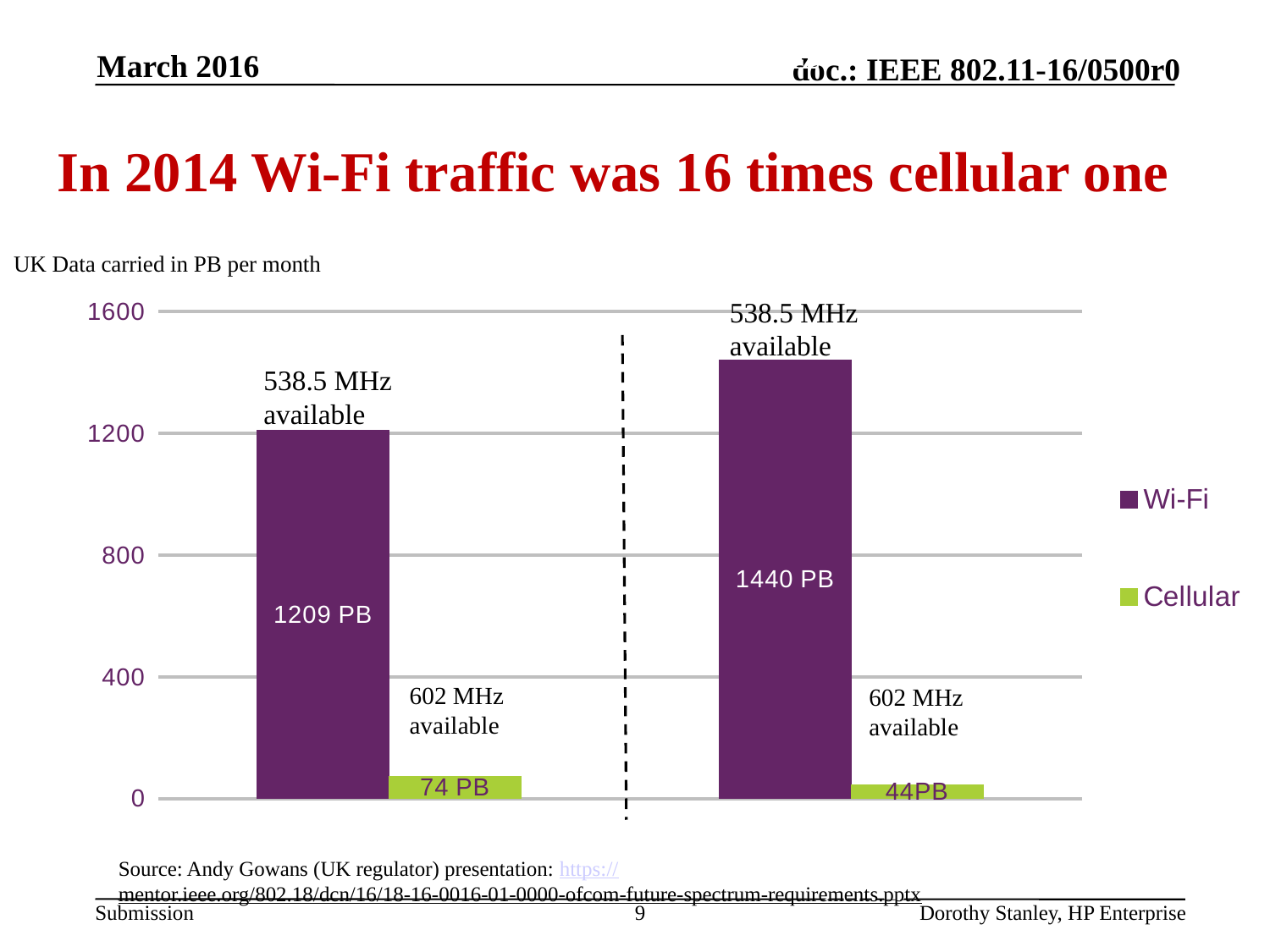
Which bar in the chart has the lowest value? Cellular in the right group (44PB) What is the Cellular value shown on the right group of bars? 44PB What kind of chart is shown on the slide? bar chart What is the Wi-Fi value shown on the right group of bars? 1440 PB Which is larger in the left group, the Wi-Fi bar or the Cellular bar? Wi-Fi What is the Cellular value shown on the left group of bars? 74 PB What is the difference between the Wi-Fi values of the right group and the left group? 231 PB How many series does the chart legend list? 2 What are the two series named in the chart legend? Wi-Fi and Cellular What is the Wi-Fi value shown on the left group of bars? 1209 PB Which bar in the chart has the highest value? Wi-Fi in the right group (1440 PB) Is the Wi-Fi value in the left group greater or less than 1200? greater